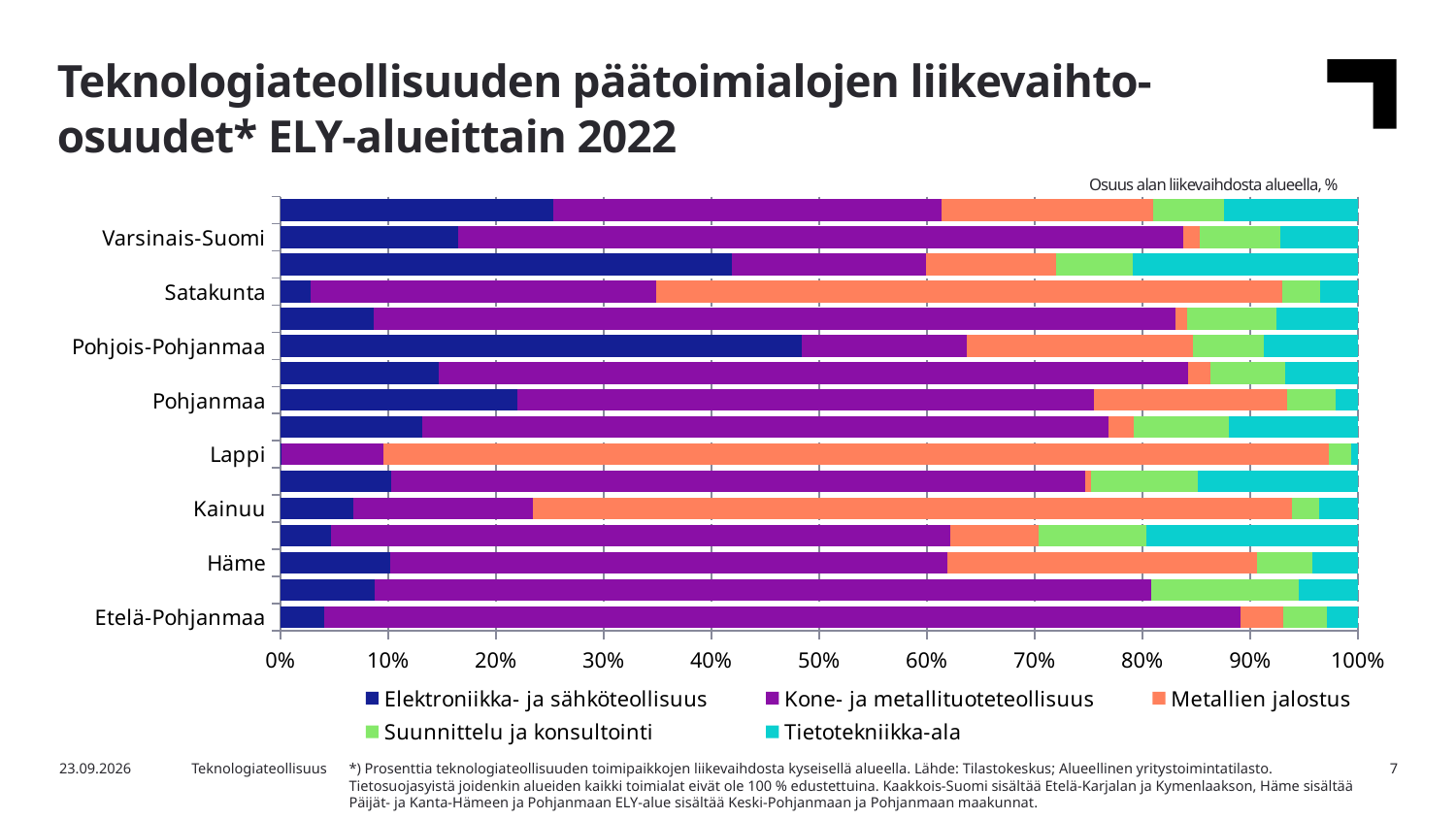
Which has the larger Elektroniikka- ja sähköteollisuus share, Pohjois-Pohjanmaa or Satakunta? Pohjois-Pohjanmaa Is the Metallien jalostus share for Kainuu greater or less than 60%? greater Is the Metallien jalostus share for Lappi greater or less than 80%? greater What kind of chart is shown on the slide? Stacked bar chart How many series does the legend list? 5 Is the Kone- ja metallituoteteollisuus share for Etelä-Pohjanmaa greater or less than 80%? greater Which has the larger Metallien jalostus share, Lappi or Häme? Lappi What is the title of the chart on the slide? Teknologiateollisuuden päätoimialojen liikevaihto-osuudet* ELY-alueittain 2022 Which series is shown in orange in the legend? Metallien jalostus